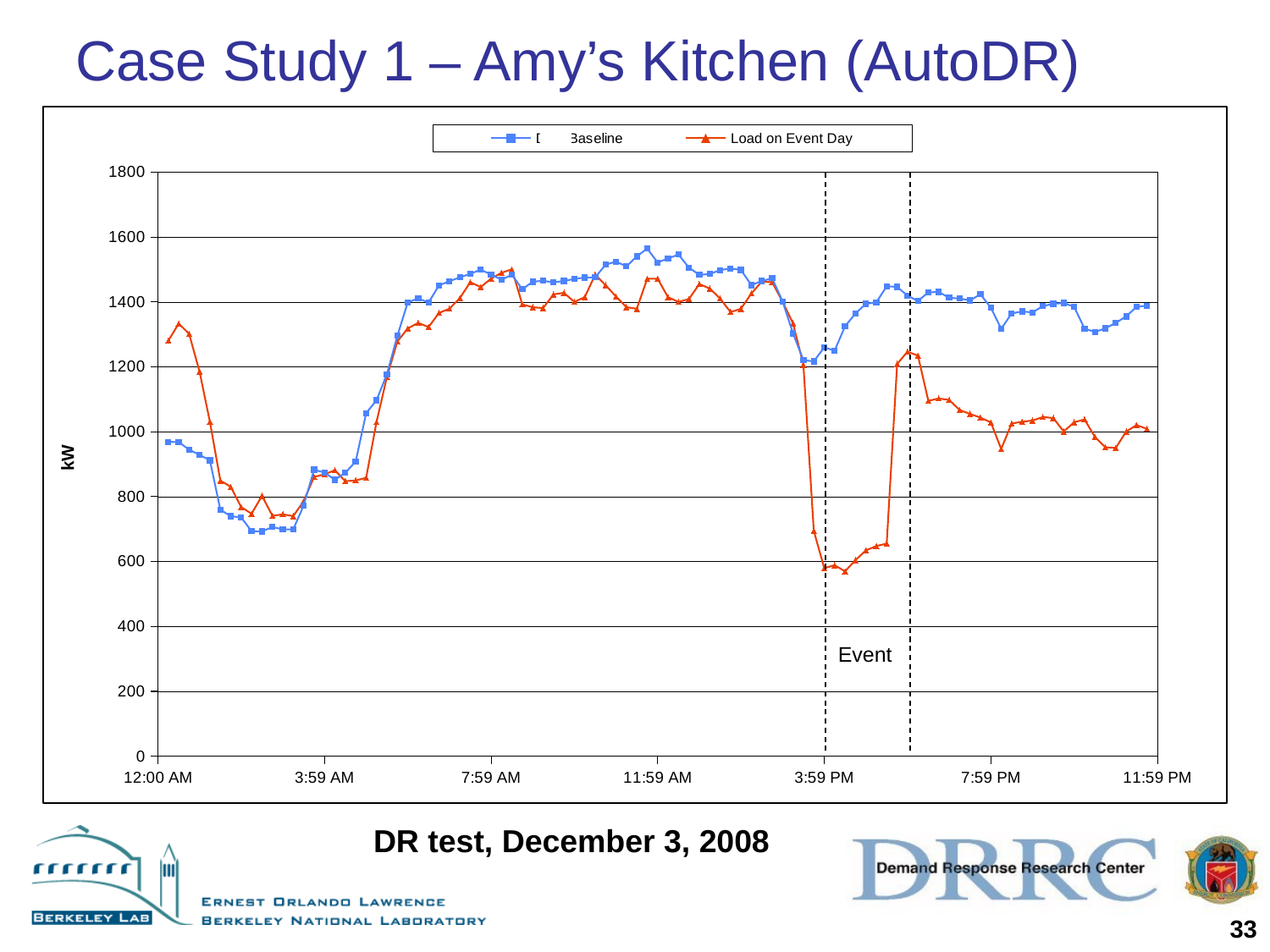
Is the Load on Event Day value at 12:00 AM greater or less than 1200? greater During the period marked 'Event', which series is higher, Baseline or Load on Event Day? Baseline How many series does the chart legend list? 2 What is the label on the chart's vertical axis? kW Which series reaches the lowest value anywhere on the chart? Load on Event Day What are the two series named in the chart legend? Baseline and Load on Event Day Is the Load on Event Day value at 7:59 PM greater or less than 1200? less Which series reaches the highest value anywhere on the chart? Baseline What is the highest value shown on the chart's vertical axis? 1800 Between 3:59 AM and 7:59 AM, does the Baseline series rise or fall? rise What kind of chart is shown on the slide? Line chart How many time labels are shown along the chart's horizontal axis? 7